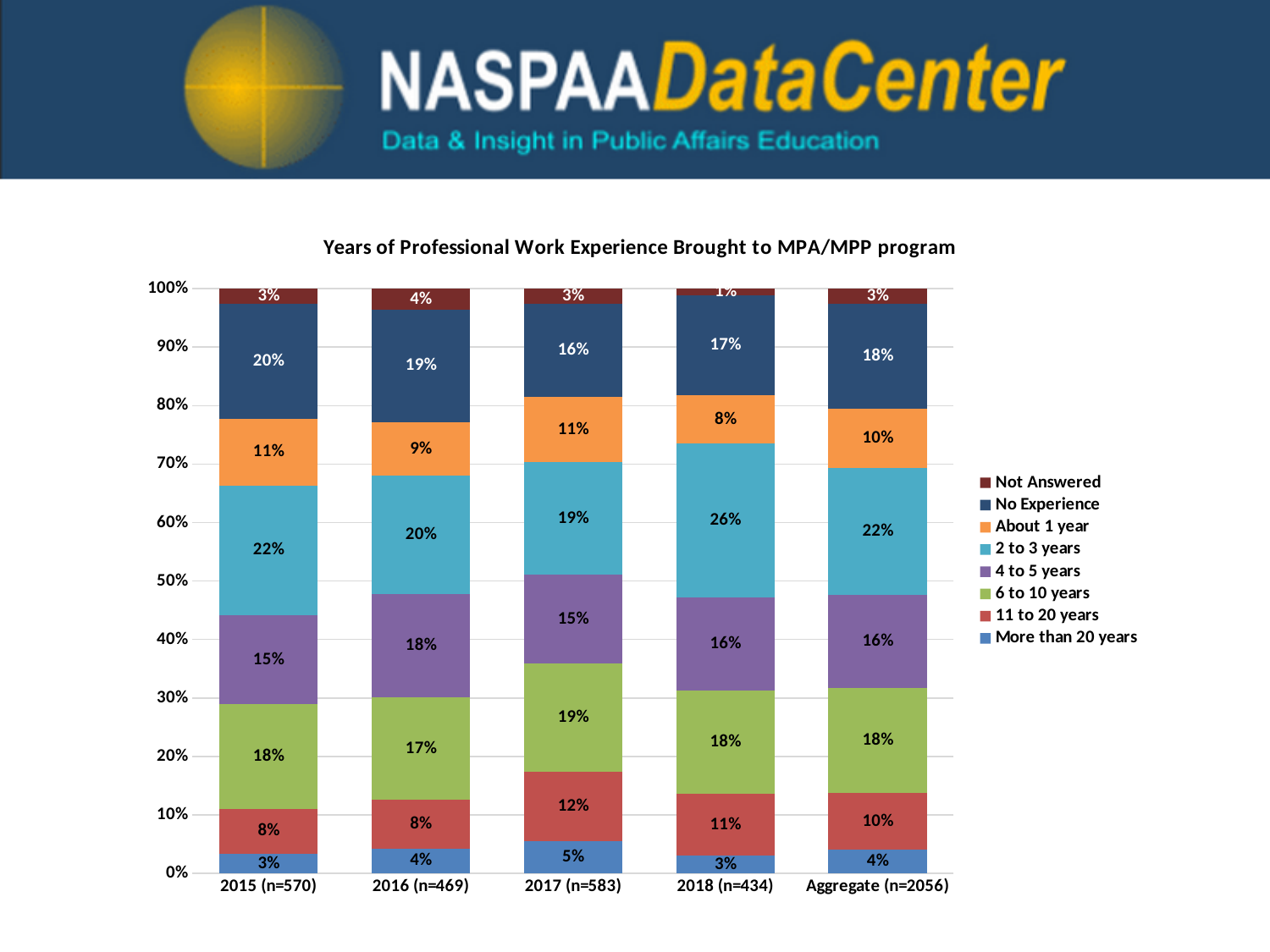
In the Aggregate (n=2056) bar, what is the value for 6 to 10 years? 18% From 2015 (n=570) to 2017 (n=583), does the No Experience share rise or fall? Fall Which is larger: the 11 to 20 years share in 2017 (n=583) or in 2016 (n=469)? 2017 (n=583) What is the No Experience share for 2015 (n=570)? 20% Which category has the lowest Not Answered share? 2018 (n=434) What type of chart is shown on the slide? Stacked bar chart What is the difference between the No Experience share in 2015 (n=570) and in 2017 (n=583)? 4 percentage points How many series does the legend list? 8 How many bars are shown on the chart? 5 What percentage of students in 2018 (n=434) brought 2 to 3 years of professional work experience? 26% Which category has the highest share for 2 to 3 years? 2018 (n=434) What is the title of the chart? Years of Professional Work Experience Brought to MPA/MPP program